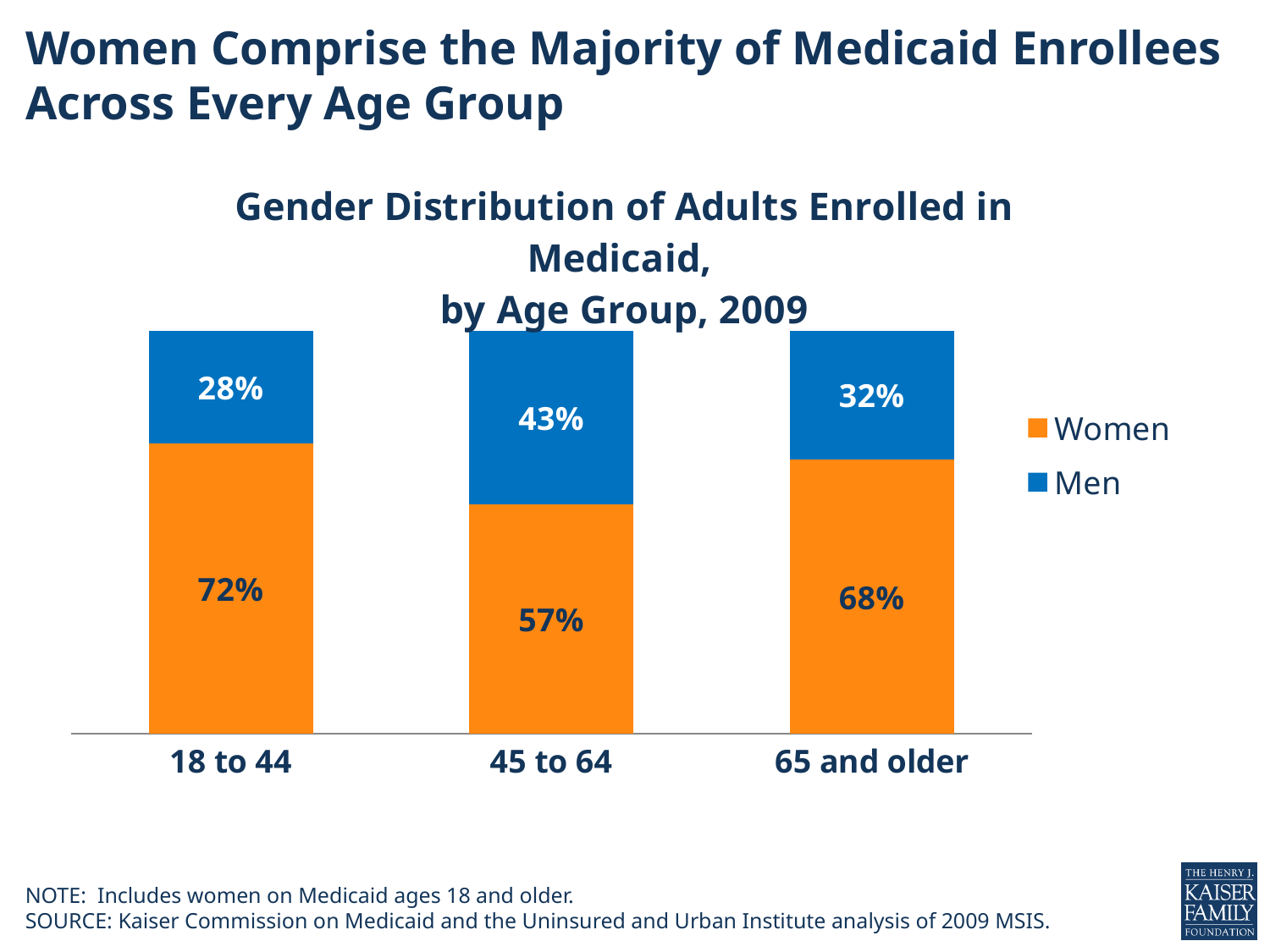
What percentage of Medicaid enrollees aged 18 to 44 are women? 72% Which age group has the lowest share of women? 45 to 64 Which age group has the highest share of women? 18 to 44 What kind of chart is shown on the slide? Stacked bar chart What is the difference between the Women and Men shares in the 45 to 64 age group? 14 percentage points What is the value for Men in the 18 to 44 age group? 28% Which colour represents Women in the chart? Orange Is the share of men larger in the 45 to 64 group or the 65 and older group? 45 to 64 What percentage of Medicaid enrollees aged 45 to 64 are men? 43% How many series does the legend list? 2 What is the value for Women in the 65 and older age group? 68% How many age groups are shown on the chart? 3